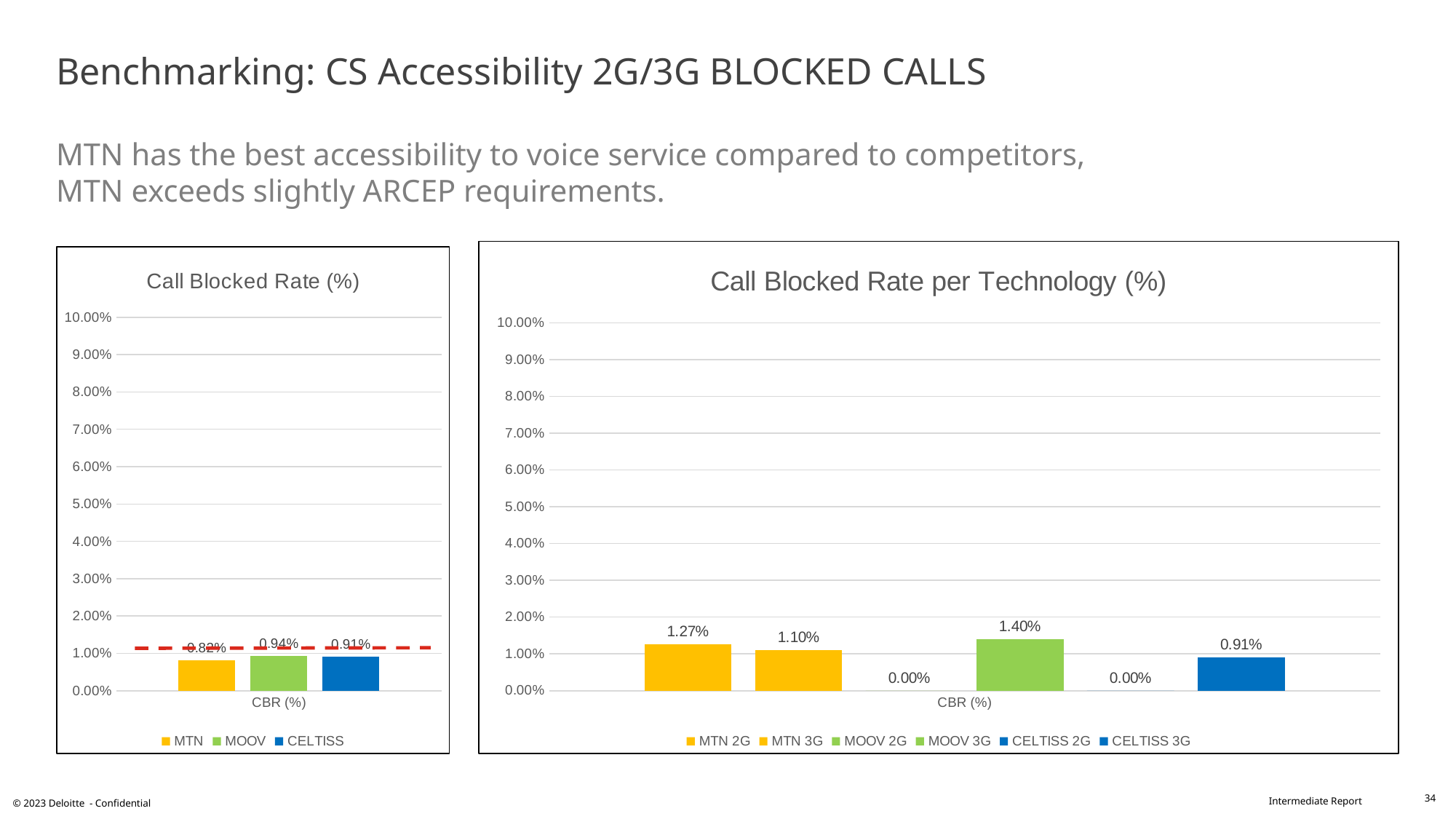
What kind of chart is the 'Call Blocked Rate (%)' chart on the left? bar chart How many series does the legend of the 'Call Blocked Rate per Technology (%)' chart list? 6 In the 'Call Blocked Rate per Technology (%)' chart, is the value for MOOV 3G greater or less than 2.00%? less In the 'Call Blocked Rate per Technology (%)' chart, what is the value for MOOV 3G? 1.40% In the 'Call Blocked Rate (%)' chart, what is the value for MOOV? 0.94% How many series does the legend of the 'Call Blocked Rate (%)' chart list? 3 In the 'Call Blocked Rate per Technology (%)' chart, which series has the highest call blocked rate? MOOV 3G In the 'Call Blocked Rate per Technology (%)' chart, what is the difference between MTN 2G and MTN 3G? 0.17% In the 'Call Blocked Rate per Technology (%)' chart, what is the value for MTN 2G? 1.27% In the 'Call Blocked Rate per Technology (%)' chart, how many series show a value of 0.00%? 2 In the 'Call Blocked Rate (%)' chart, which operator has the lowest call blocked rate? MTN In the 'Call Blocked Rate per Technology (%)' chart, which is larger, MTN 3G or CELTISS 3G? MTN 3G